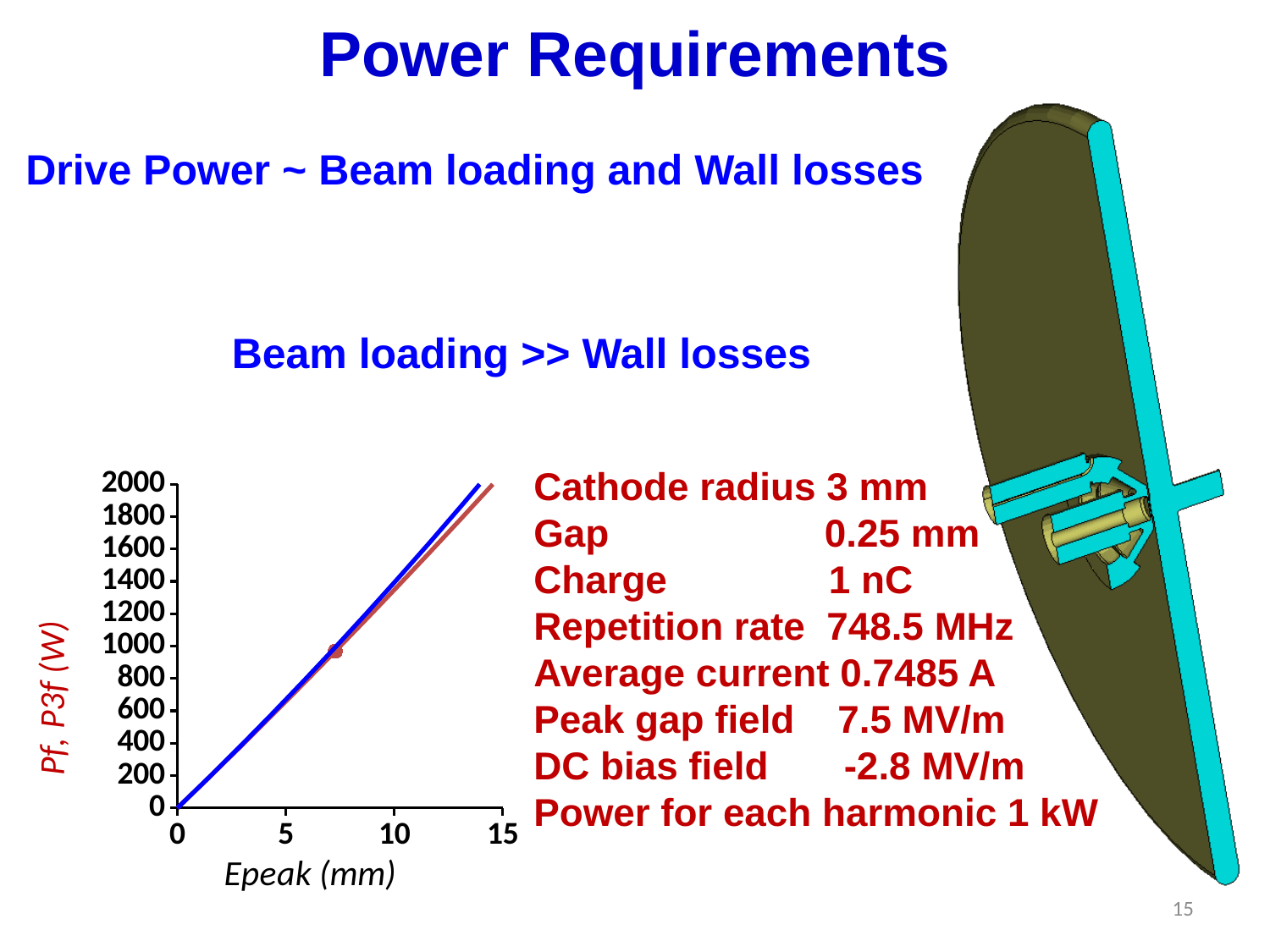
What is the highest value shown on the y axis of the chart? 2000 Is the value of the blue line at Epeak = 5 greater or less than 400? greater How many lines are plotted on the chart? 2 Is the value of the blue line at Epeak = 10 greater or less than 1000? greater What is the label of the x axis of the chart? Epeak (mm) Is the value of the red line at Epeak = 10 greater or less than 1800? less Do the plotted values rise or fall as Epeak increases along the x axis? rise What kind of chart is shown on the slide? line chart What is the label of the y axis of the chart? Pf, P3f (W)